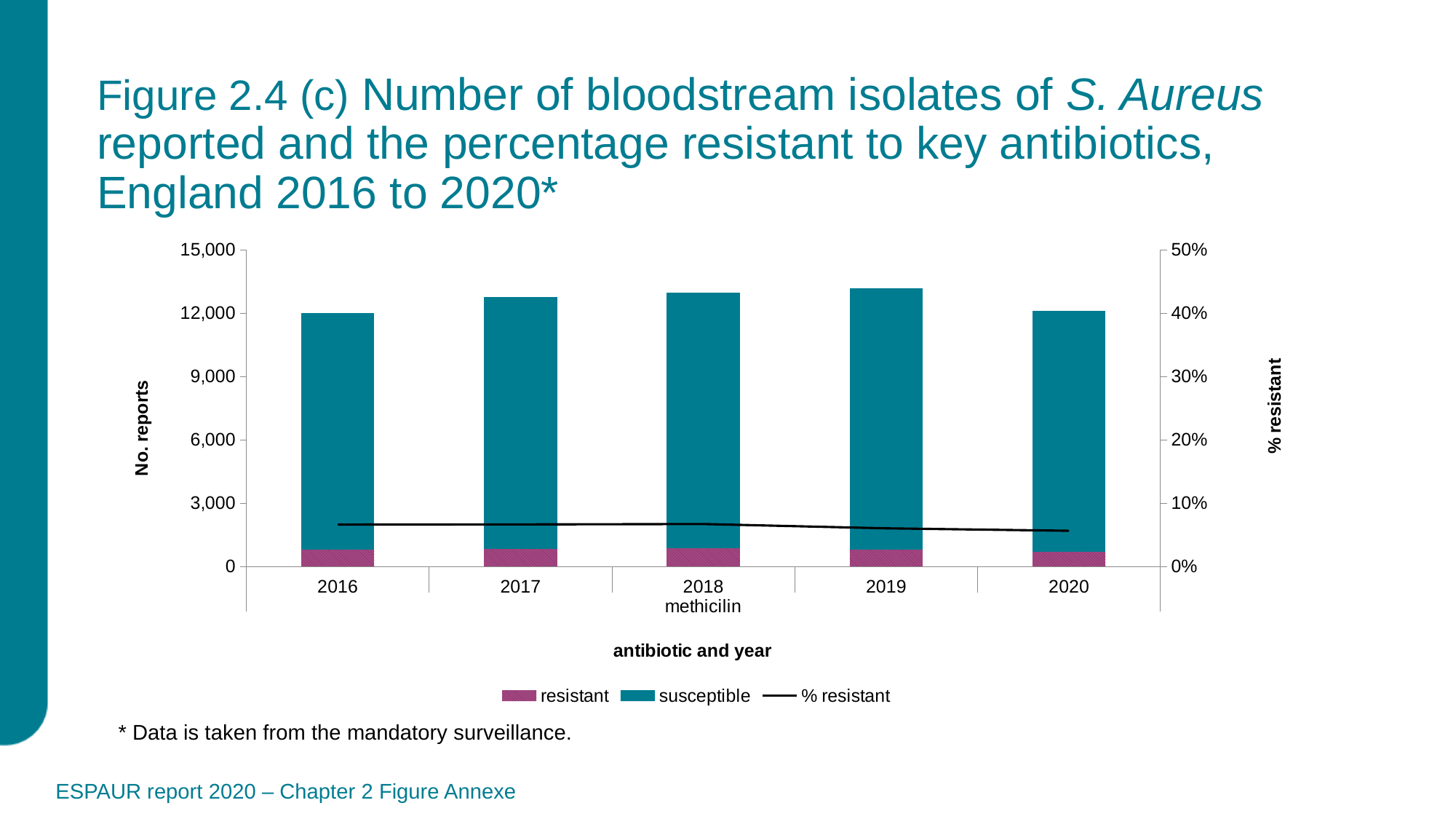
Is the % resistant value for 2020 greater or less than 10%? less Is the total number of reports for 2019 greater or less than 12,000? greater Is the number of resistant reports for 2016 greater or less than 3,000? less Which antibiotic is the chart about, according to the x axis label? methicilin How many years are shown on the x axis of the chart? 5 Which series are listed in the chart legend? resistant, susceptible, % resistant How many series does the chart legend list? 3 Which year has the larger total number of reports, 2019 or 2020? 2019 Which year has the larger total number of reports, 2016 or 2017? 2017 What kind of chart is shown on the slide? Stacked bar chart with a line